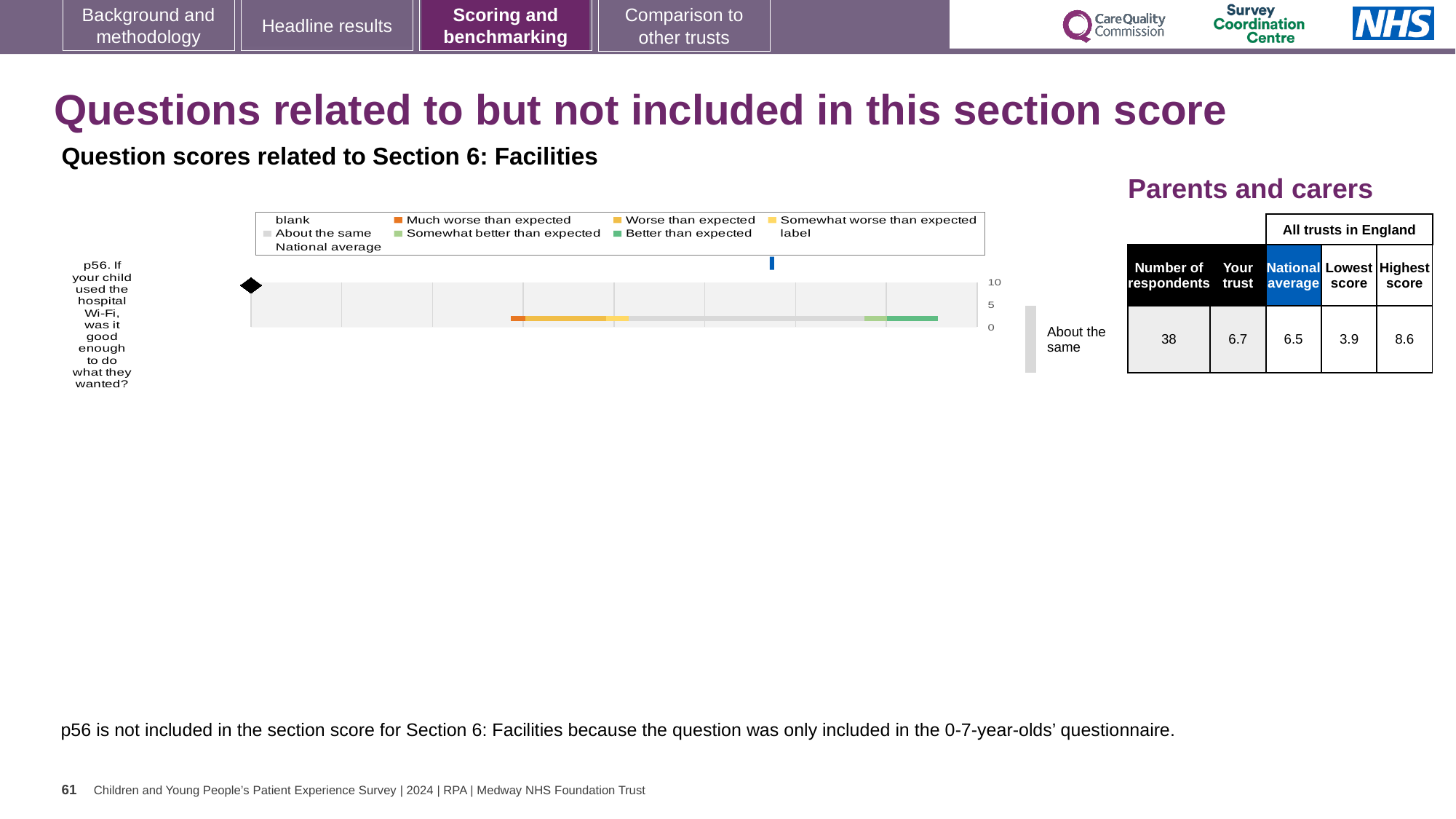
What is the 'Your trust' score for p56? 6.7 What is the difference between the Highest score and the Lowest score for p56? 4.7 What is the Lowest score among all trusts in England for p56? 3.9 How many questions are plotted on the chart? 1 What kind of chart is used to show the p56 question score? bar chart What is the Highest score among all trusts in England for p56? 8.6 Which question number is shown on the chart? p56 What is the difference between the 'Your trust' score and the National average for p56? 0.2 How many respondents answered p56? 38 Which is higher for p56, the 'Your trust' score or the National average? Your trust What is the National average score for p56? 6.5 What benchmark category is the trust's p56 score placed in? About the same